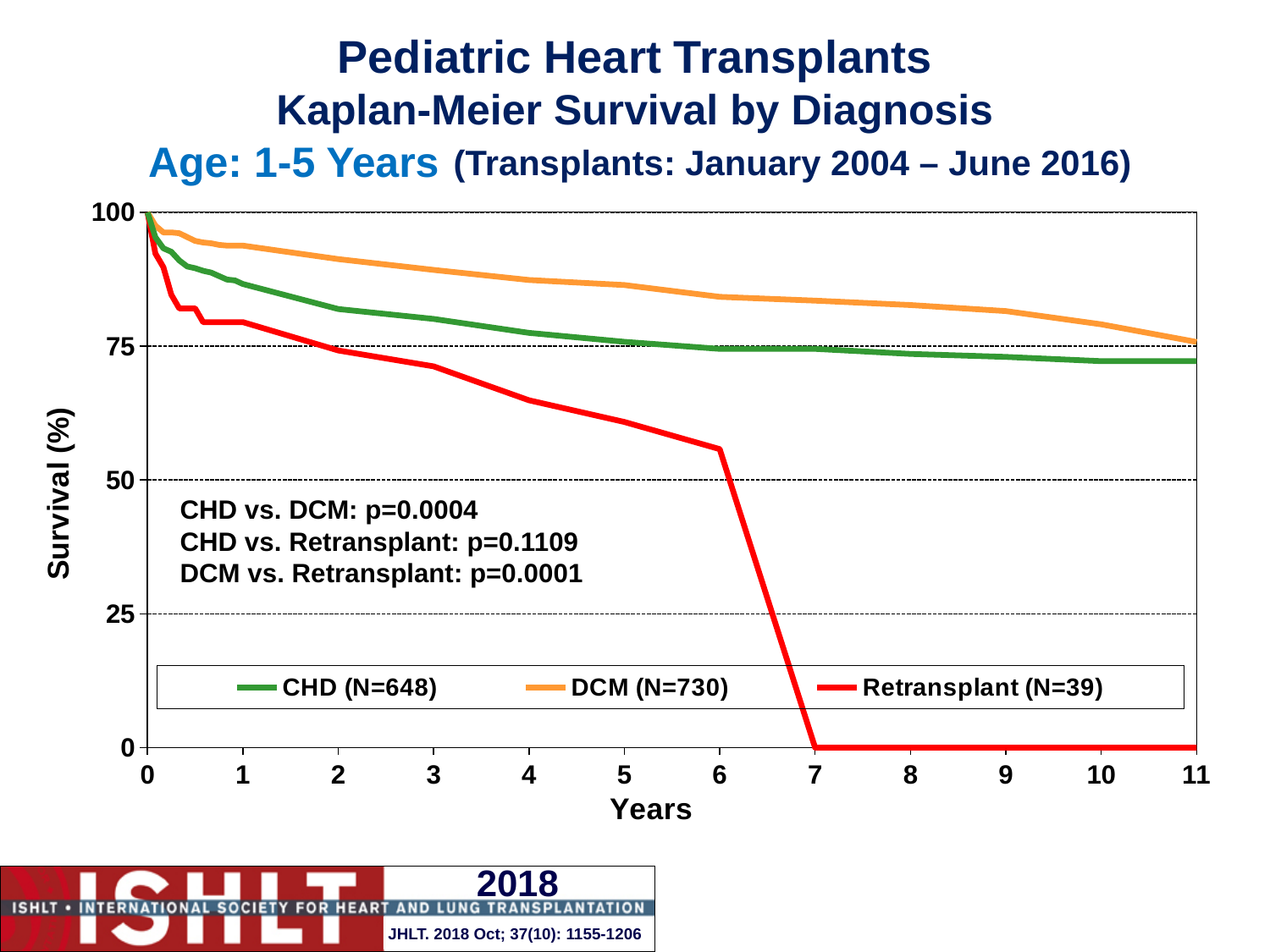
What is the survival value for the Retransplant series at year 7? 0 What kind of chart is shown on the slide? line chart Which series has the lowest survival at year 8? Retransplant Is the survival value for DCM at year 5 greater or less than 75? greater How many series does the legend list? 3 Do the survival curves rise or fall as years increase? fall What is the survival value for all three series at year 0? 100 Is the survival value for Retransplant at year 5 greater or less than 50? greater At year 6, which series has higher survival, CHD or Retransplant? CHD Which series has the highest survival at year 10? DCM Is the survival value for CHD at year 10 greater or less than 75? less